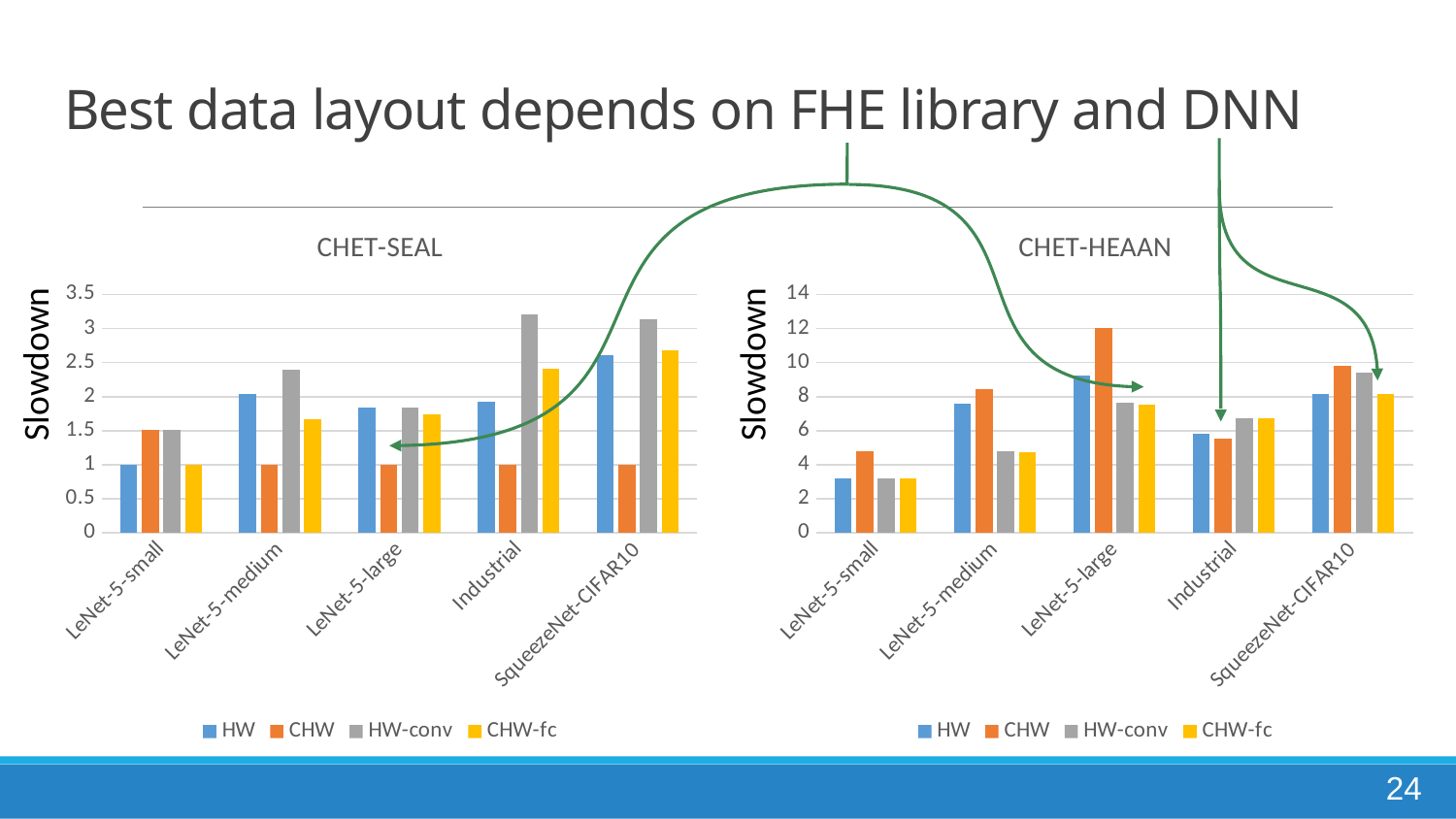
What is the y-axis label of the CHET-SEAL chart? Slowdown In the CHET-SEAL chart, what is the CHW value for Industrial? 1 In the CHET-HEAAN chart, which series has the highest value for LeNet-5-large? CHW In the CHET-SEAL chart, which is larger for Industrial: HW-conv or CHW-fc? HW-conv In the CHET-SEAL chart, is the HW-conv value for Industrial greater or less than 3? greater How many categories are shown on the x axis of the CHET-SEAL chart? 5 In the CHET-HEAAN chart, which is larger for SqueezeNet-CIFAR10: CHW or HW? CHW In the CHET-HEAAN chart, is the HW value for LeNet-5-small greater or less than 4? less How many series does the legend of the CHET-HEAAN chart list? 4 In the CHET-SEAL chart, which series has the lowest value for LeNet-5-medium? CHW In the CHET-HEAAN chart, is the CHW value for LeNet-5-large greater or less than 10? greater What kind of chart is the CHET-SEAL chart? bar chart